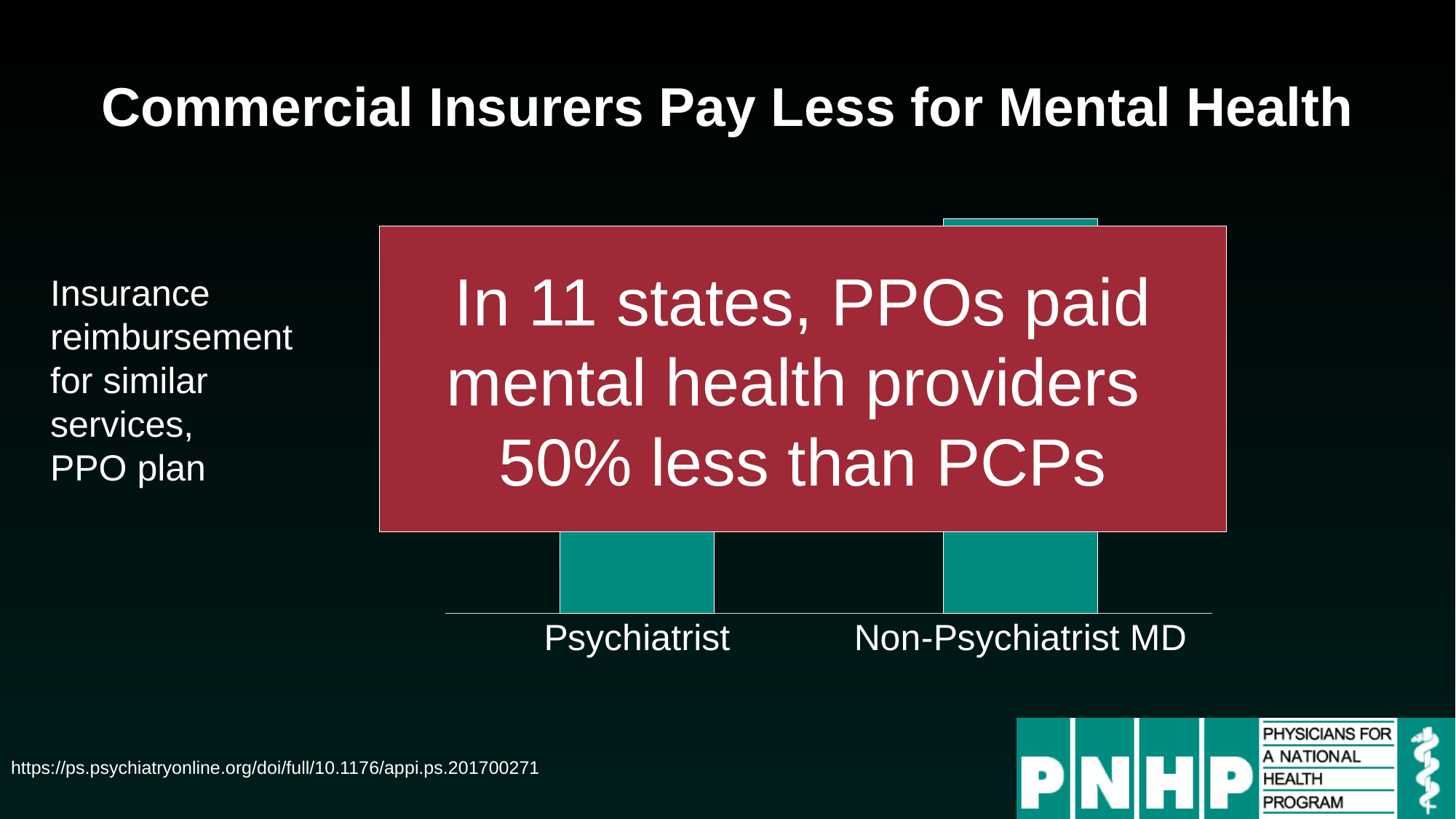
What are the two category labels on the x axis of the chart? Psychiatrist and Non-Psychiatrist MD How many categories are plotted on the bar chart? 2 According to the text overlaid on the chart, how much less did PPOs pay mental health providers than PCPs in 11 states? 50% less Is the bar for Psychiatrist taller or shorter than the bar for Non-Psychiatrist MD? shorter What is the title of the slide containing the chart? Commercial Insurers Pay Less for Mental Health Which category has the taller bar on the chart? Non-Psychiatrist MD Which category has the shorter bar on the chart? Psychiatrist What kind of chart is shown on the slide? bar chart